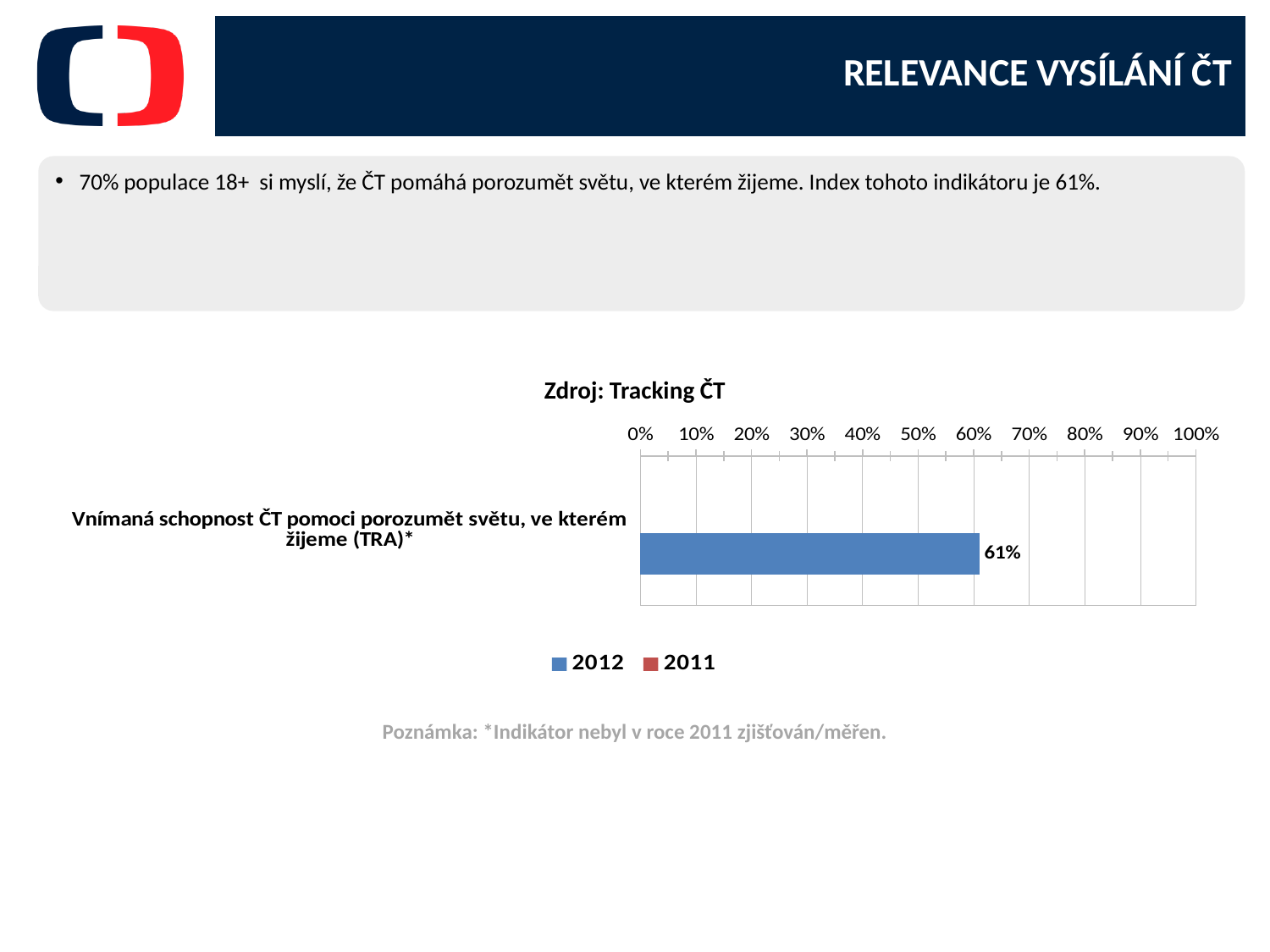
What is the 2012 value for 'Vnímaná schopnost ČT pomoci porozumět světu, ve kterém žijeme (TRA)*'? 61% What is the title of the chart? Zdroj: Tracking ČT Which series is shown in blue in the legend? 2012 Is the 2012 value for 'Vnímaná schopnost ČT pomoci porozumět světu, ve kterém žijeme (TRA)*' greater or less than 50%? greater What kind of chart is shown on the slide? bar chart How many categories are plotted on the chart? 1 What is the highest value shown on the x axis? 100% How many series does the legend list? 2 Is the 2012 value for 'Vnímaná schopnost ČT pomoci porozumět světu, ve kterém žijeme (TRA)*' greater or less than 70%? less